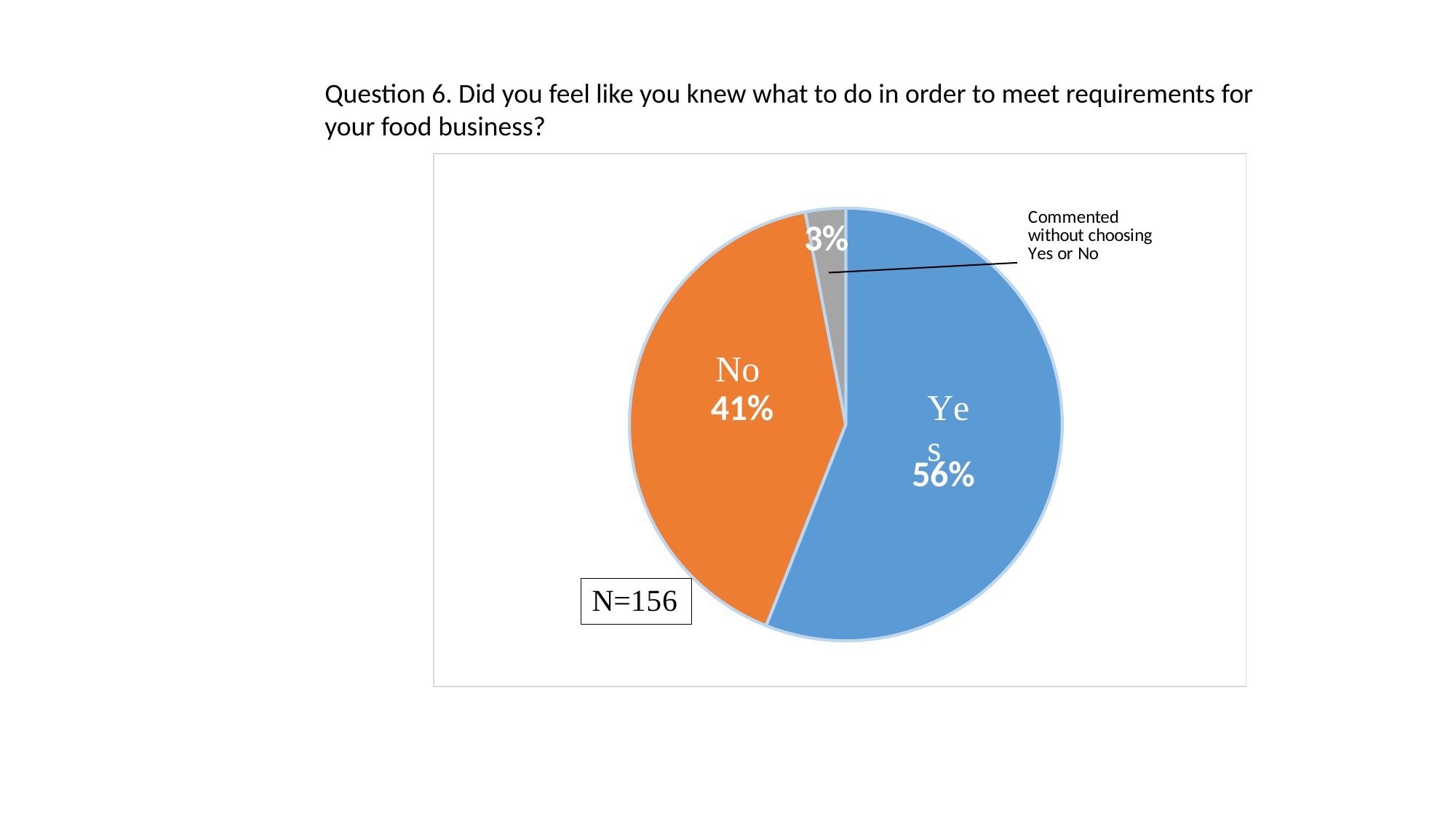
What percentage of respondents answered No? 41% What percentage of respondents commented without choosing Yes or No? 3% What is the difference in percentage points between the Yes and No slices? 15 What is the difference in percentage points between the No slice and the Commented without choosing Yes or No slice? 38 Which slice is larger, Yes or No? Yes Which response has the smallest share of the pie? Commented without choosing Yes or No Which response has the largest share of the pie? Yes How many slices does the pie chart have? 3 What percentage of respondents answered Yes? 56% What type of chart is shown on the slide? pie chart What colour is the No slice? orange What is the sample size (N) shown on the chart? 156